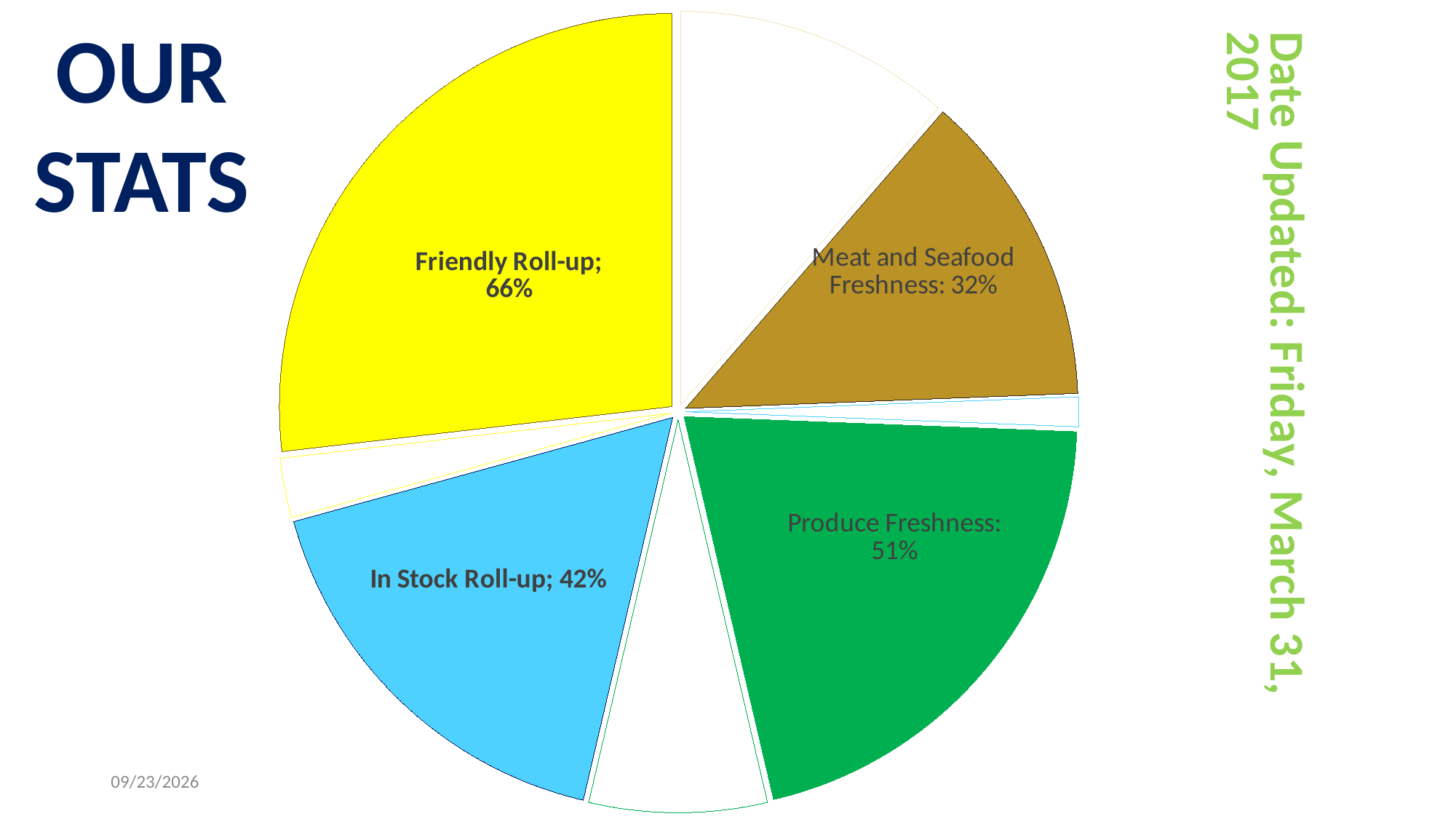
What is the difference between the Friendly Roll-up value and the In Stock Roll-up value? 24% What colour is the Friendly Roll-up slice? yellow What value is shown for Meat and Seafood Freshness? 32% What kind of chart is shown on the slide? pie chart How many slices of the pie chart have a printed label? 4 Which labeled slice has the lowest value? Meat and Seafood Freshness What value is shown for Produce Freshness? 51% What value is shown for Friendly Roll-up? 66% What value is shown for In Stock Roll-up? 42% Which labeled slice has the highest value? Friendly Roll-up What is the title shown on the slide? OUR STATS Which is larger, Produce Freshness or In Stock Roll-up? Produce Freshness